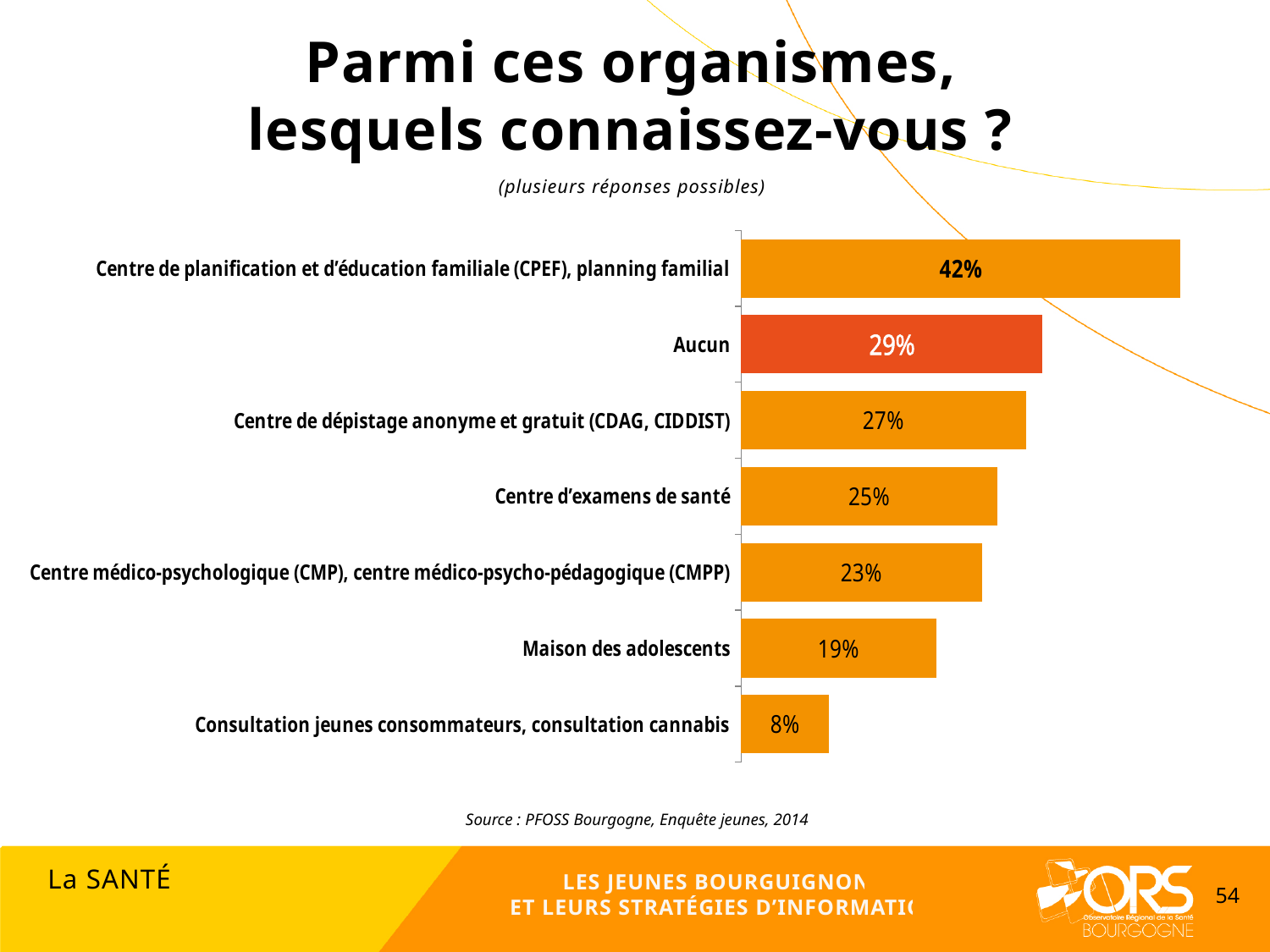
What is the difference between the value for Centre de dépistage anonyme et gratuit (CDAG, CIDDIST) and the value for Centre d'examens de santé? 2% Which is larger: the value for Centre médico-psychologique (CMP), centre médico-psycho-pédagogique (CMPP) or the value for Maison des adolescents? Centre médico-psychologique (CMP), centre médico-psycho-pédagogique (CMPP) What type of chart is shown on the slide? Bar chart How many categories are shown on the chart? 7 What percentage is shown for Maison des adolescents? 19% What is the value shown for Aucun? 29% Which organisation has the highest percentage on the chart? Centre de planification et d'éducation familiale (CPEF), planning familial Which category has the lowest value on the chart? Consultation jeunes consommateurs, consultation cannabis Which bar is shown in a different colour (red) from the others? Aucun What percentage of respondents know the Centre de planification et d'éducation familiale (CPEF), planning familial? 42% What is the value for Consultation jeunes consommateurs, consultation cannabis? 8% What is the difference between the value for CPEF, planning familial and the value for Aucun? 13%